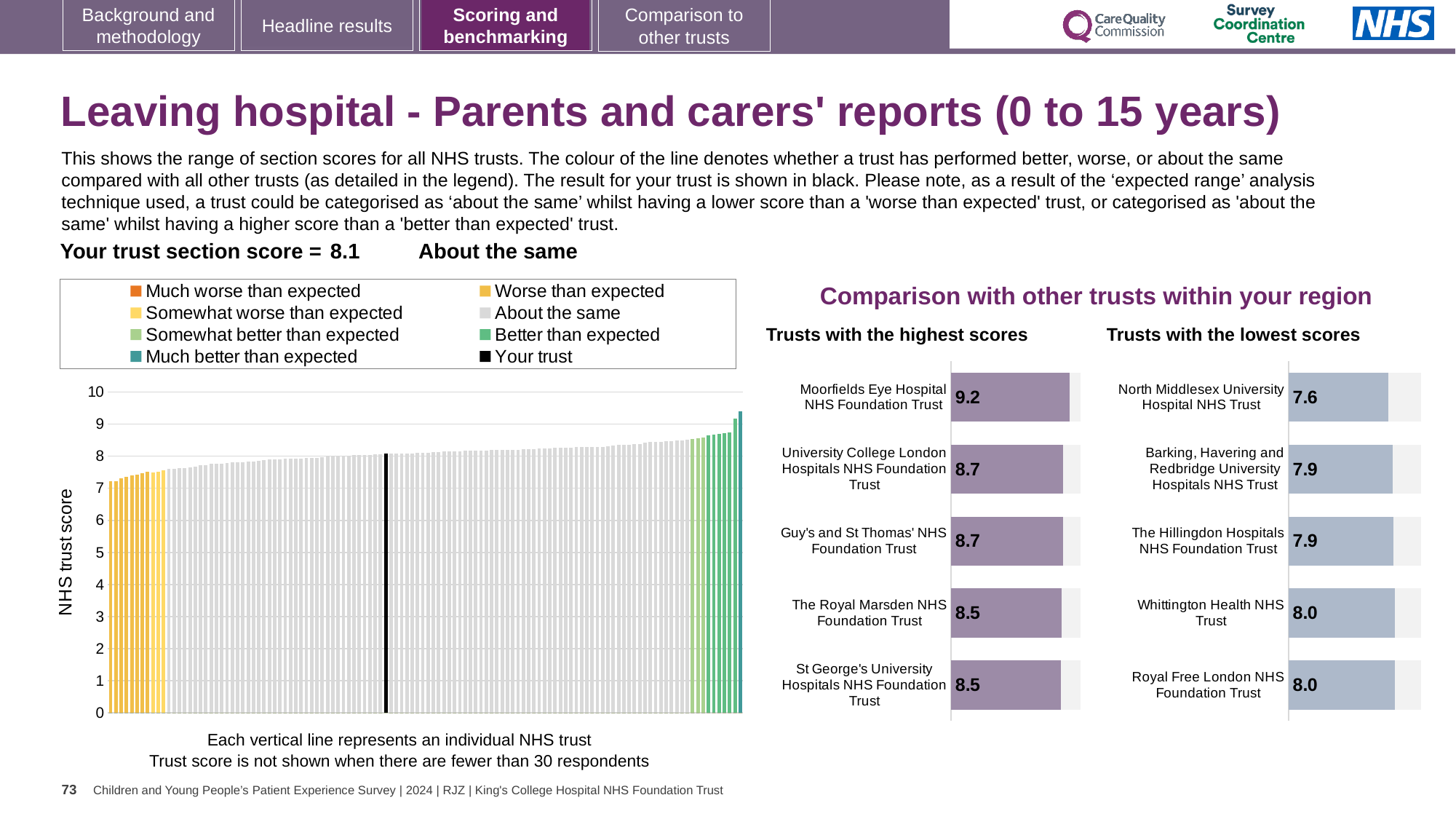
In the large 'NHS trust score' chart, do the values rise or fall from left to right? Rise In the 'Trusts with the lowest scores' chart, what is the difference between the scores of Royal Free London NHS Foundation Trust and North Middlesex University Hospital NHS Trust? 0.4 How many entries does the legend of the large 'NHS trust score' chart list? 8 In the 'Trusts with the lowest scores' chart, which trust has the lowest score? North Middlesex University Hospital NHS Trust In the 'Trusts with the highest scores' chart, what is the score for Moorfields Eye Hospital NHS Foundation Trust? 9.2 In the large 'NHS trust score' chart, is the value of the tallest bar on the far right greater or less than 9? greater How many trusts are shown in the 'Trusts with the lowest scores' chart? 5 In the 'Trusts with the highest scores' chart, what is the difference between the scores of Moorfields Eye Hospital NHS Foundation Trust and The Royal Marsden NHS Foundation Trust? 0.7 In the 'Trusts with the highest scores' chart, which trust has the highest score? Moorfields Eye Hospital NHS Foundation Trust In the 'Trusts with the lowest scores' chart, what is the score for North Middlesex University Hospital NHS Trust? 7.6 Which is larger: the score for Guy's and St Thomas' NHS Foundation Trust in the highest scores chart, or the score for Whittington Health NHS Trust in the lowest scores chart? Guy's and St Thomas' NHS Foundation Trust What kind of chart is the large chart with the 'NHS trust score' axis? Bar chart